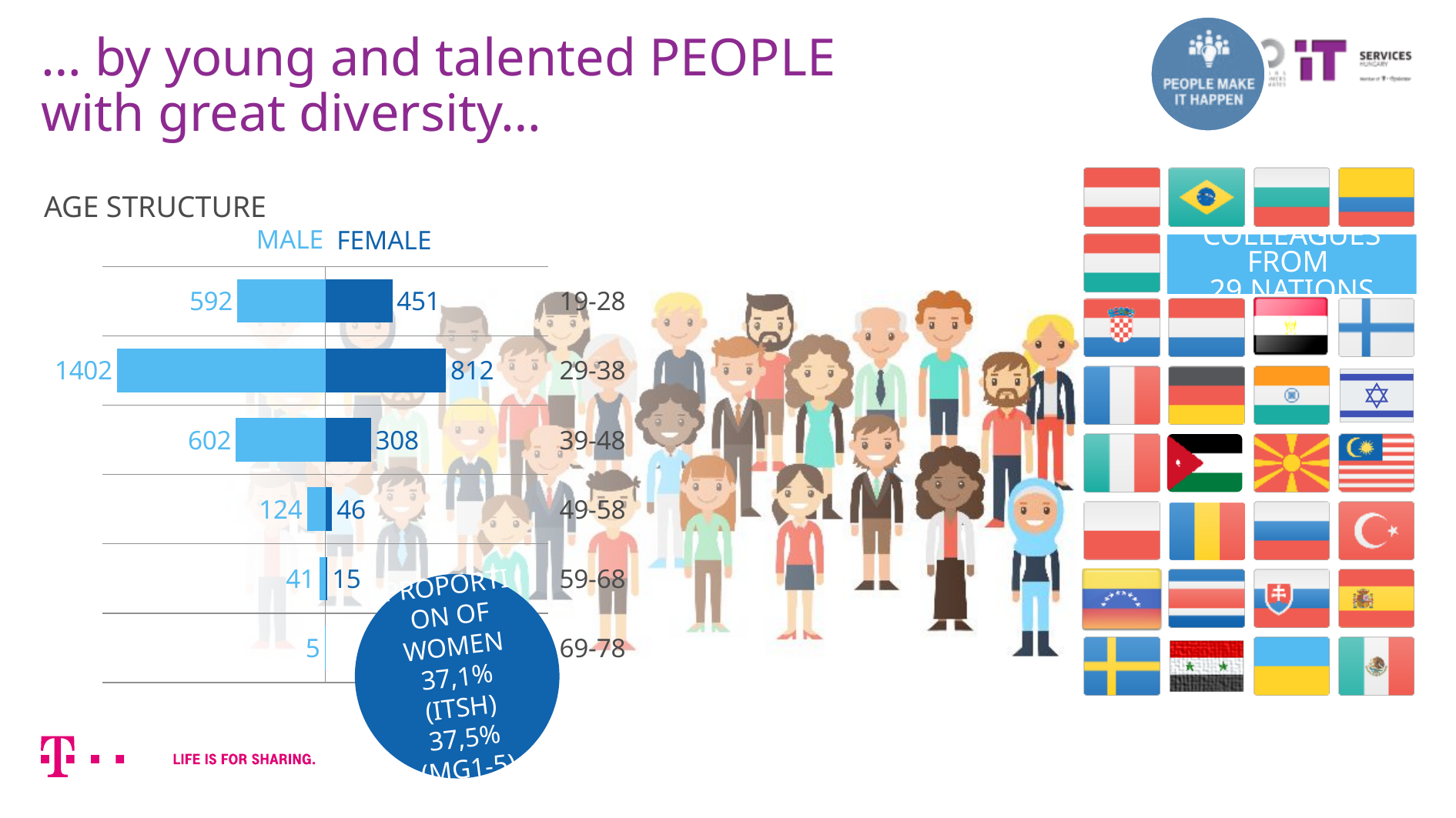
What is the FEMALE value for the 19-28 age group? 451 Which age group has the highest MALE value? 29-38 What is the FEMALE value for the 39-48 age group? 308 What is the difference between the MALE and FEMALE values for the 29-38 age group? 590 Which age group has the lowest FEMALE value among those with a printed label? 59-68 What is the MALE value for the 59-68 age group? 41 What is the title of the chart on the slide? AGE STRUCTURE Is the MALE value for the 39-48 age group larger than the MALE value for the 19-28 age group? Yes What is the MALE value for the 29-38 age group? 1402 How many age groups are shown in the AGE STRUCTURE chart? 6 What kind of chart is the AGE STRUCTURE chart? bar chart How many series does the AGE STRUCTURE chart show? 2